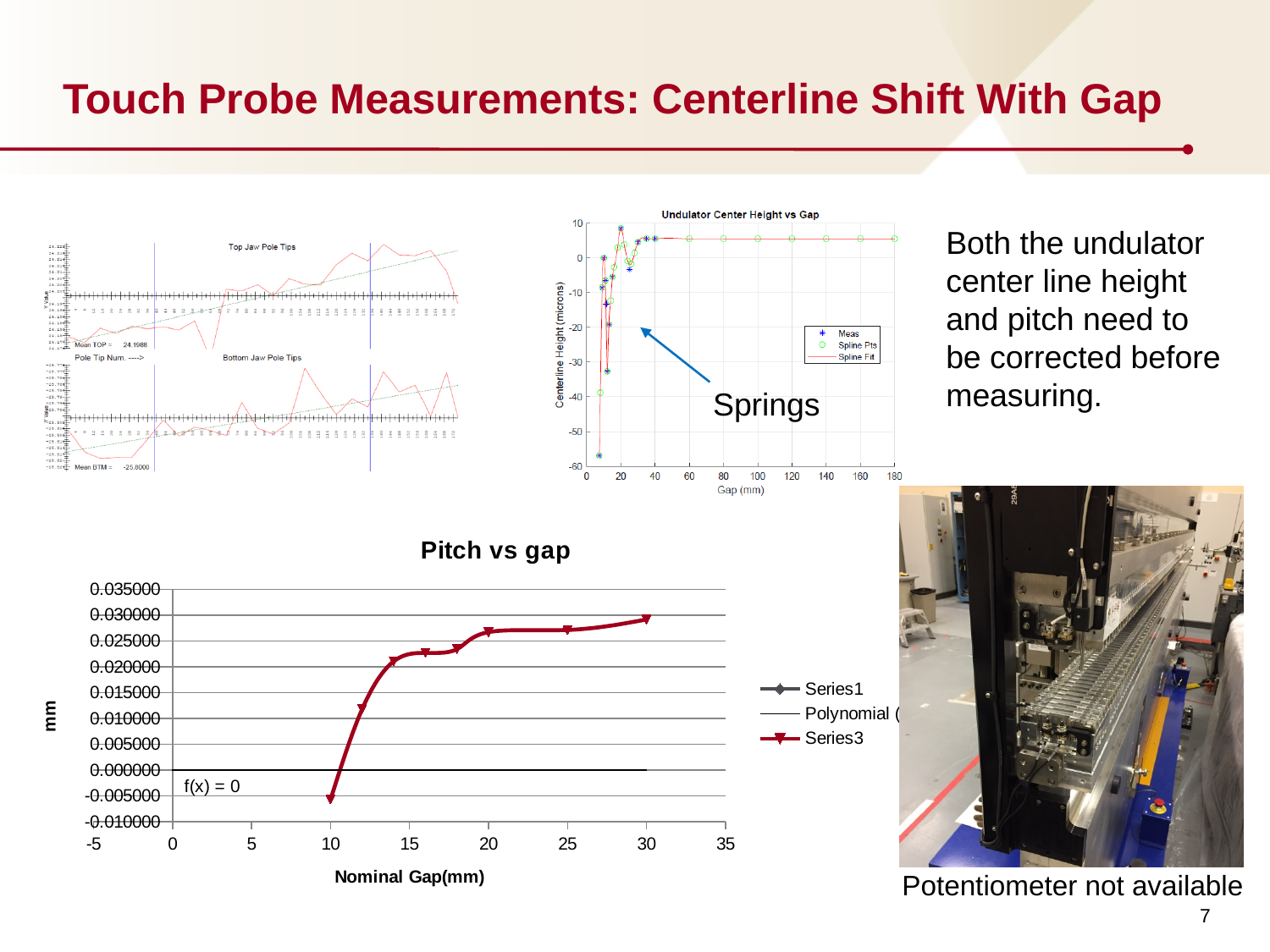
In the "Pitch vs gap" chart, is the value at a nominal gap of 12 mm greater or less than 0.010000? greater In the "Pitch vs gap" chart, is the value at a nominal gap of 30 mm greater or less than 0.025000? greater How many entries does the legend of the "Undulator Center Height vs Gap" chart list? 3 In the "Pitch vs gap" chart, what is the label of the y axis? mm How many entries does the legend of the "Pitch vs gap" chart list? 3 In the "Undulator Center Height vs Gap" chart, is the centerline height at a gap of 180 mm greater or less than 0? greater What kind of chart is the "Pitch vs gap" chart? line chart In the "Pitch vs gap" chart, do the plotted values rise or fall as the nominal gap increases from 10 mm to 30 mm? rise In the "Pitch vs gap" chart, how many data points are marked on the Series3 line? 8 In the "Pitch vs gap" chart, what is the label of the x axis? Nominal Gap(mm)